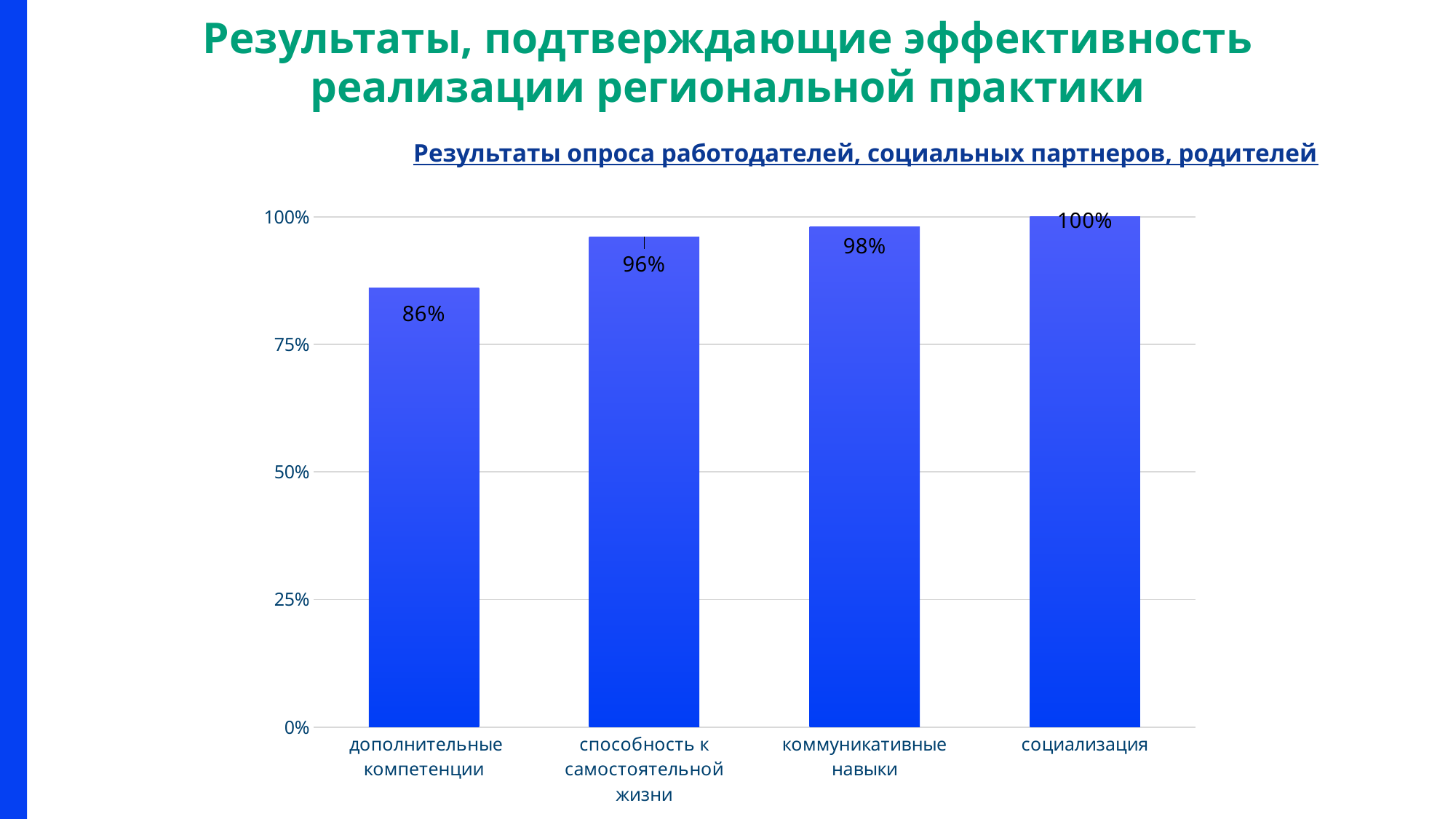
What is the value for дополнительные компетенции? 86% What is the difference between the values for социализация and дополнительные компетенции? 14% Do the values rise or fall from left to right along the x axis? rise Which category has the lowest value? дополнительные компетенции What is the value for коммуникативные навыки? 98% How many categories are shown in the chart? 4 What is the value for способность к самостоятельной жизни? 96% What kind of chart is shown on the slide? bar chart What is the title of the chart? Результаты опроса работодателей, социальных партнеров, родителей Which is larger: the value for способность к самостоятельной жизни or the value for дополнительные компетенции? способность к самостоятельной жизни What is the value for социализация? 100% Which category has the highest value? социализация